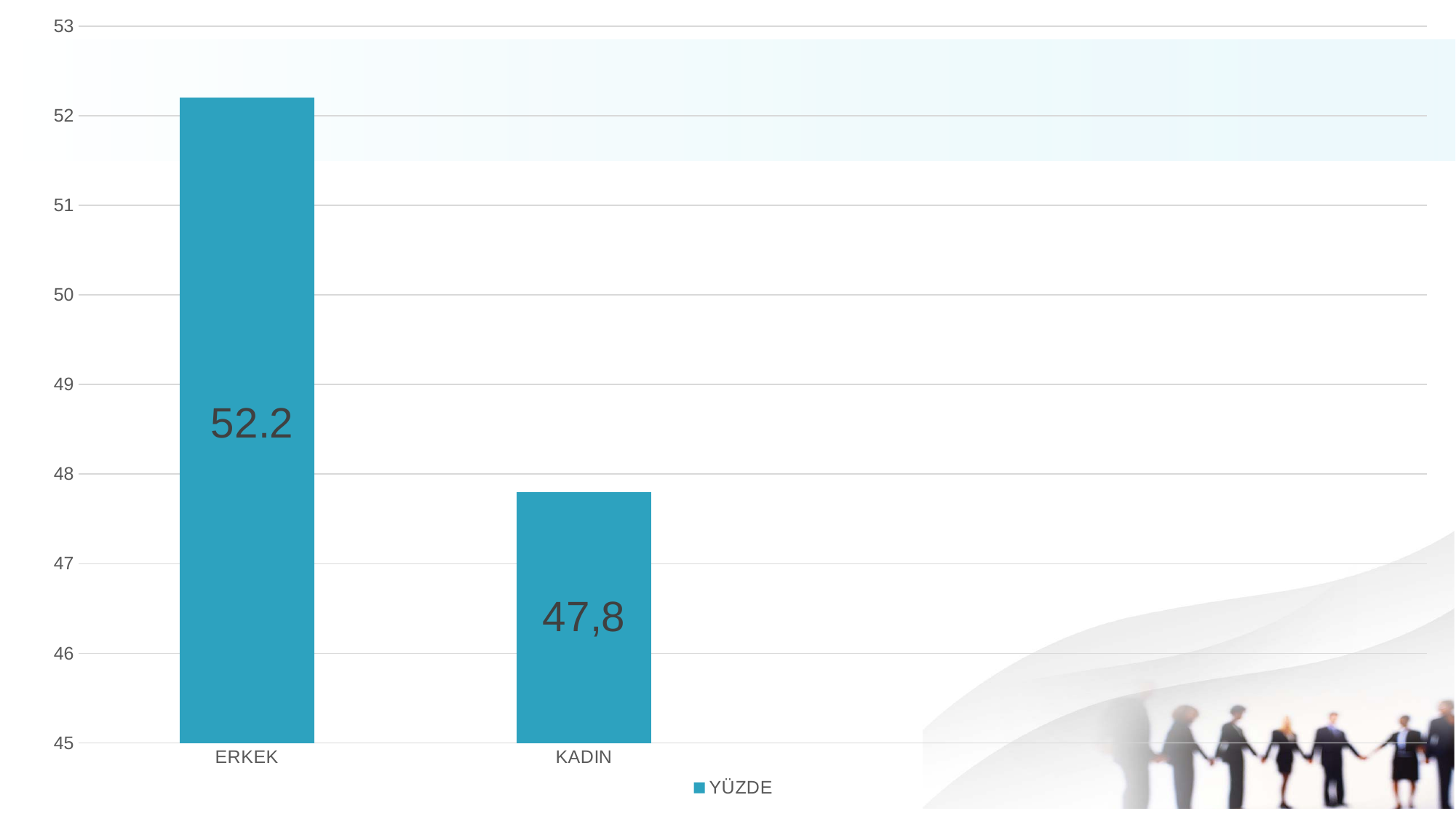
Which is larger, the value for ERKEK or the value for KADIN? ERKEK Is the value for ERKEK greater or less than 52? greater How many series does the legend list? 1 Which category has the lowest value? KADIN What is the difference between the values for ERKEK and KADIN? 4.4 How many categories are shown on the x axis? 2 What is the value for ERKEK? 52.2 What kind of chart is shown on the slide? bar chart What is the name of the series shown in the legend? YÜZDE What is the value for KADIN? 47,8 Which category has the highest value? ERKEK Is the value for KADIN greater or less than 50? less